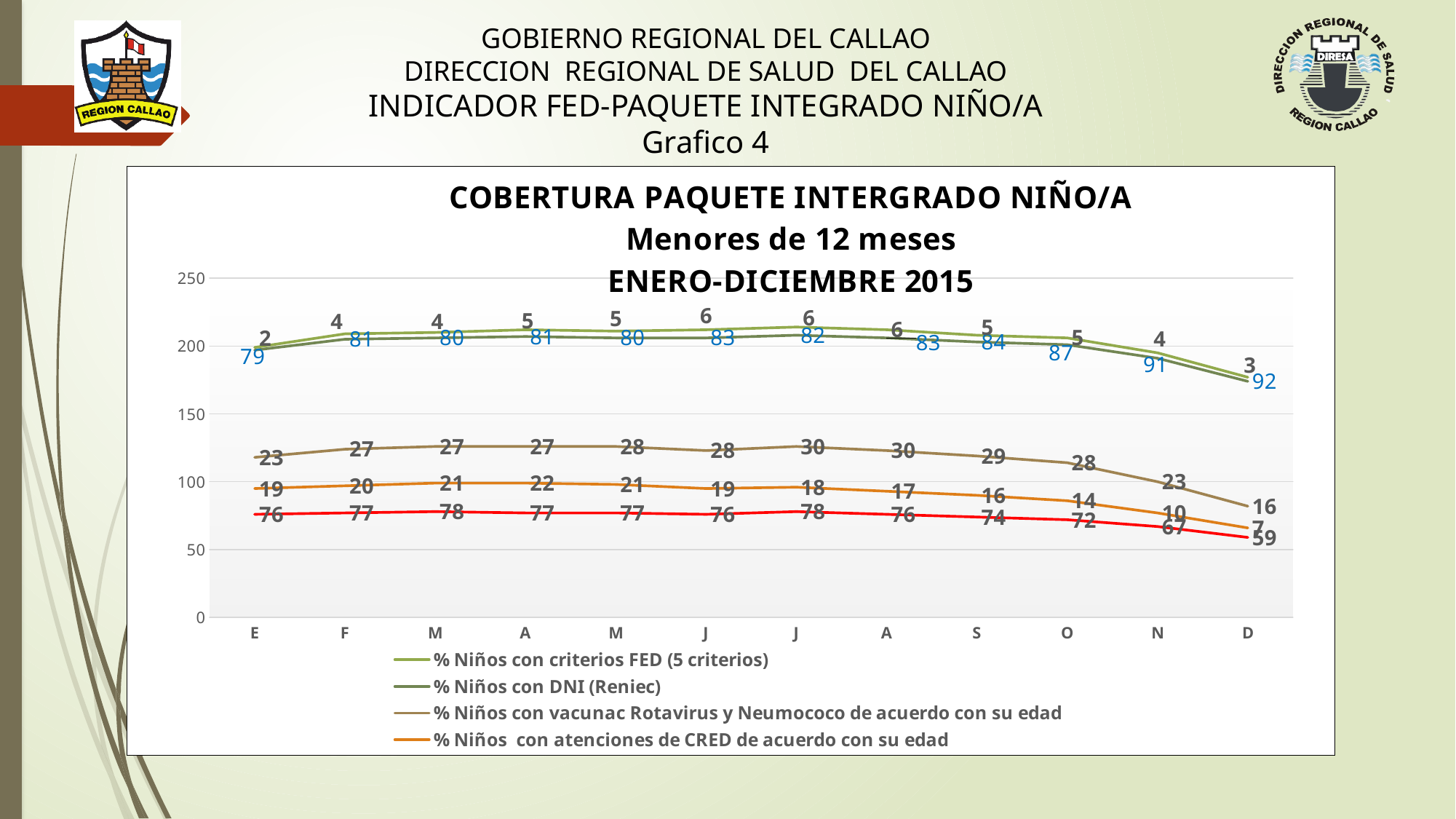
What kind of chart is shown? line chart In which month is % Niños con DNI (Reniec) highest? D What is the value for % Niños con vacunac Rotavirus y Neumococo de acuerdo con su edad in F? 27 How many months are shown on the x axis? 12 Which is larger for % Niños con vacunac Rotavirus y Neumococo de acuerdo con su edad: the value in J (July) or in D? J (July) What is the value for % Niños con criterios FED (5 criterios) in E? 2 Does % Niños con atenciones de CRED de acuerdo con su edad rise or fall from J (July) to D? fall What is the value for % Niños con DNI (Reniec) in D? 92 How many series does the legend list? 4 What is the value for % Niños con atenciones de CRED de acuerdo con su edad in A (April)? 22 In which month is % Niños con atenciones de CRED de acuerdo con su edad lowest? D What is the difference between the % Niños con DNI (Reniec) values in D and E? 13